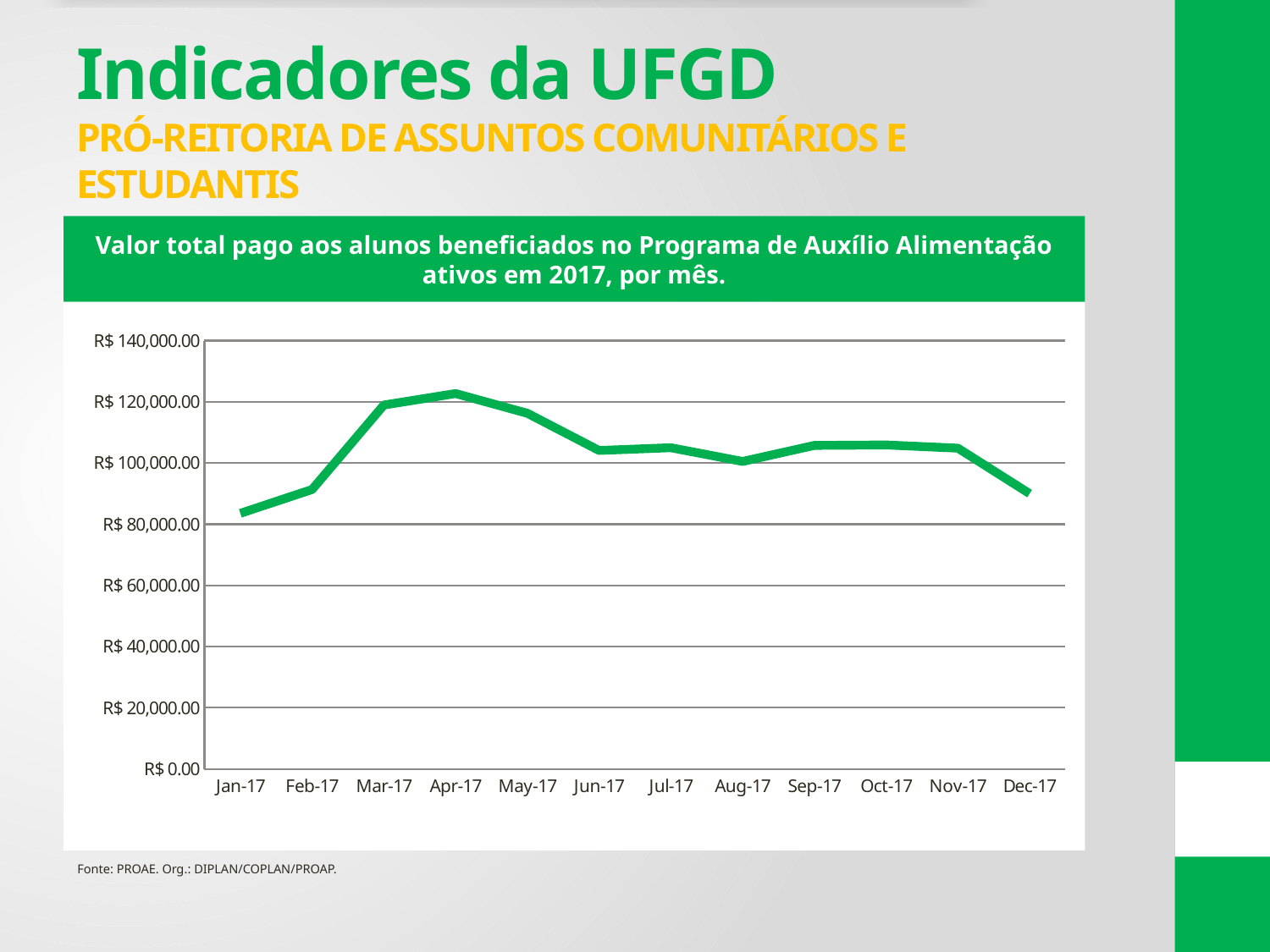
Do the values rise or fall from Jan-17 to Apr-17? rise Is the value for Dec-17 greater or less than R$ 100,000.00? less What kind of chart is shown on the slide? line chart Which is larger, the value for Apr-17 or the value for Dec-17? Apr-17 Which is larger, the value for Feb-17 or the value for Mar-17? Mar-17 Is the value for Mar-17 greater or less than R$ 100,000.00? greater Which month has the lowest value in the chart? Jan-17 Which month has the highest value in the chart? Apr-17 What is the title of the chart on the slide? Valor total pago aos alunos beneficiados no Programa de Auxílio Alimentação ativos em 2017, por mês. Is the value for Jan-17 greater or less than R$ 100,000.00? less How many months are plotted on the x axis of the chart? 12